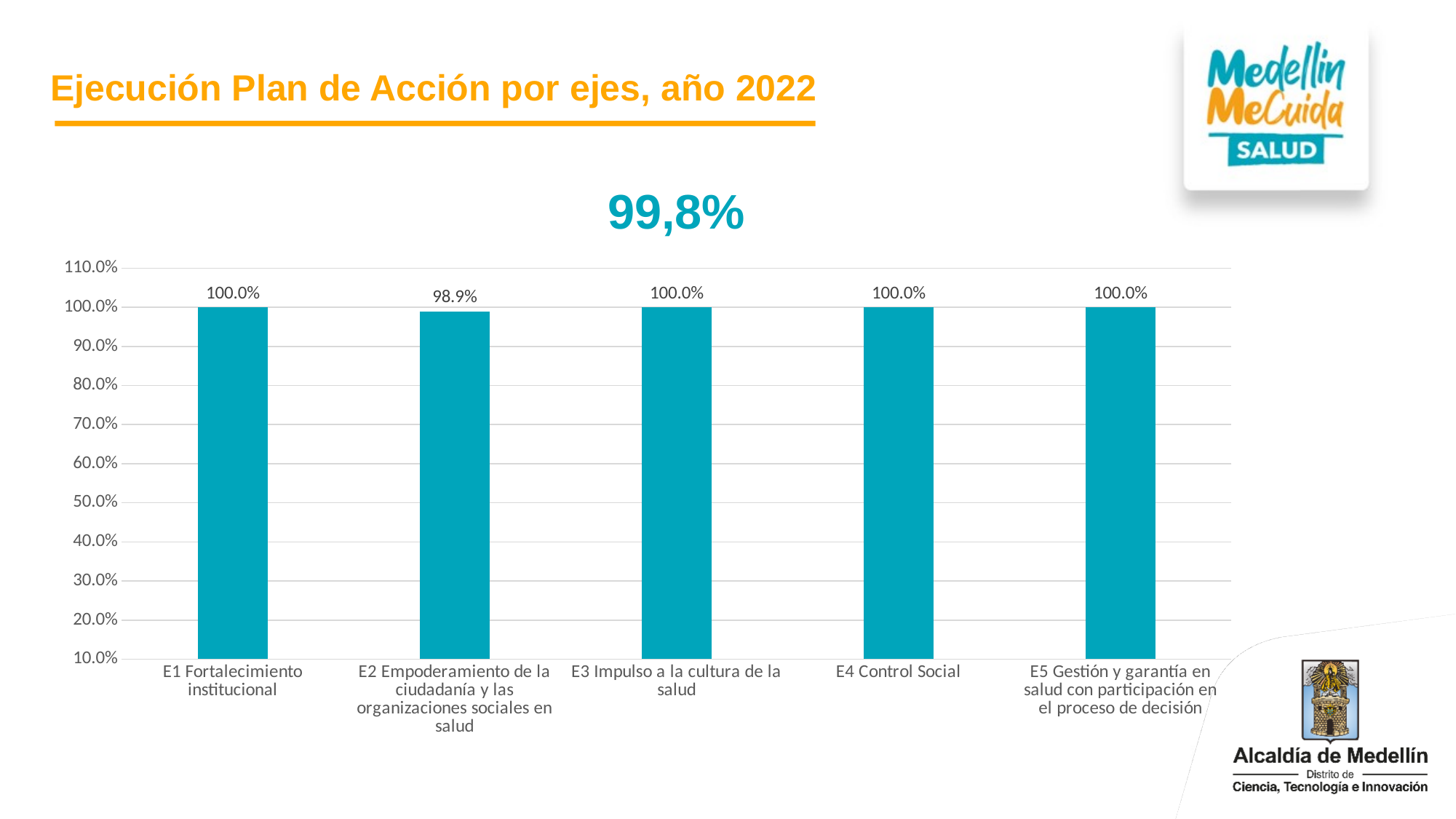
What large percentage figure is printed above the chart? 99,8% What is the value for E4 Control Social? 100.0% What is the difference between the value for E3 Impulso a la cultura de la salud and the value for E2 Empoderamiento de la ciudadanía y las organizaciones sociales en salud? 1.1% How many categories have a value of 100.0%? 4 What is the value for E1 Fortalecimiento institucional? 100.0% Is the value for E5 Gestión y garantía en salud con participación en el proceso de decisión greater or less than 90.0%? greater What kind of chart is shown on the slide? bar chart What is the title of the slide? Ejecución Plan de Acción por ejes, año 2022 How many categories are shown on the x axis? 5 What is the value for E2 Empoderamiento de la ciudadanía y las organizaciones sociales en salud? 98.9% Which category has the lowest value? E2 Empoderamiento de la ciudadanía y las organizaciones sociales en salud Which is larger, the value for E1 Fortalecimiento institucional or the value for E2 Empoderamiento de la ciudadanía y las organizaciones sociales en salud? E1 Fortalecimiento institucional